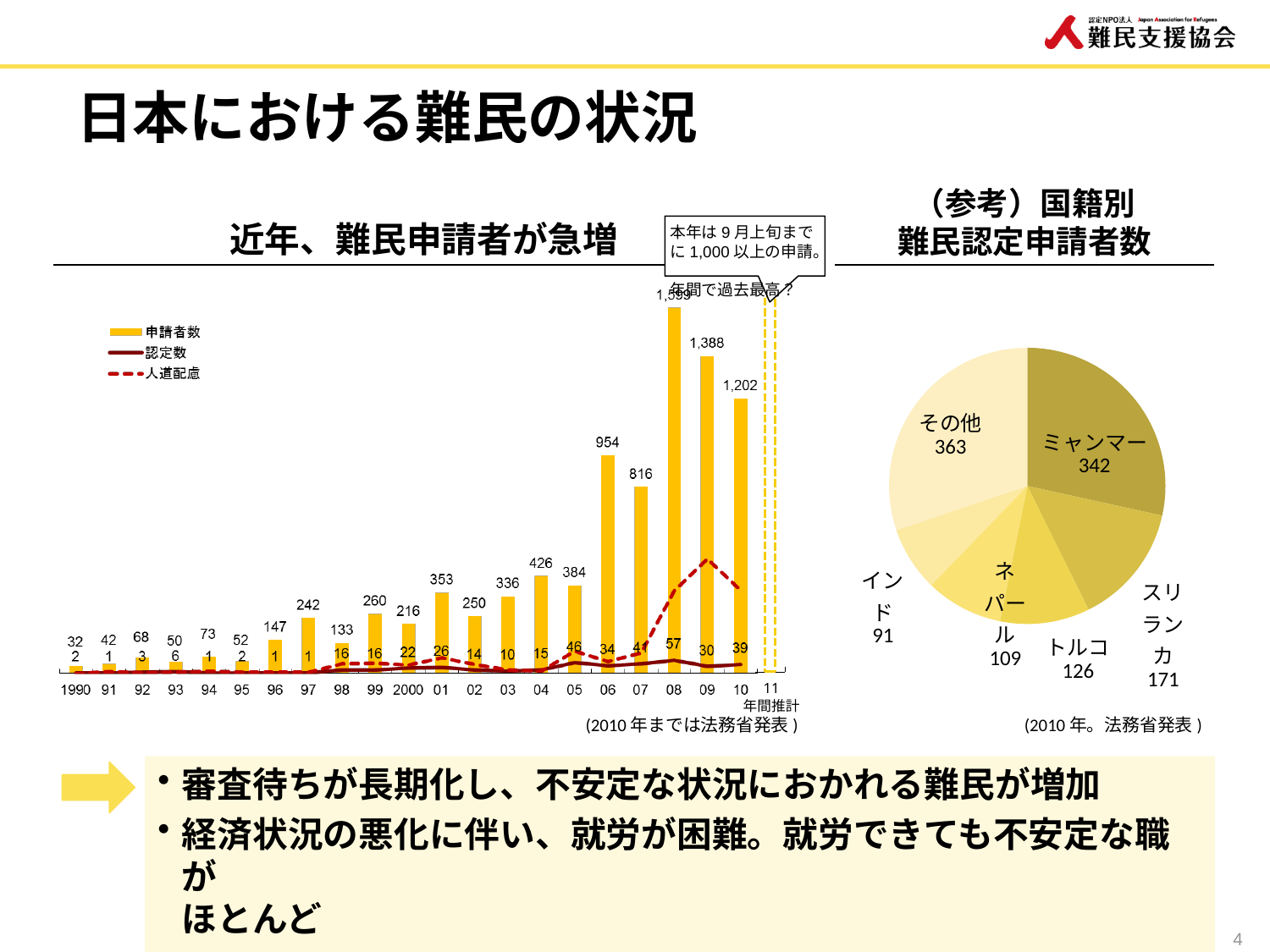
In the left chart 近年、難民申請者が急増, what is the 申請者数 value for 06? 954 In the left chart 近年、難民申請者が急増, what is the 認定数 value for 08? 57 How many series does the legend of the left chart 近年、難民申請者が急増 list? 3 In the left chart 近年、難民申請者が急増, what is the 申請者数 value for 09? 1,388 In the left chart 近年、難民申請者が急増, which year has the lowest 申請者数 bar? 1990 In the left chart 近年、難民申請者が急増, what is the difference between the 申請者数 values for 09 and 10? 186 How many slices does the pie chart （参考）国籍別難民認定申請者数 have? 6 In the pie chart （参考）国籍別難民認定申請者数, what is the value for トルコ? 126 What kind of chart is the right chart titled （参考）国籍別難民認定申請者数? pie chart What kind of chart is the left chart titled 近年、難民申請者が急増? bar chart (with line series) In the pie chart （参考）国籍別難民認定申請者数, which slice has the smallest value? インド In the left chart 近年、難民申請者が急増, which year has the larger 申請者数, 04 or 05? 04